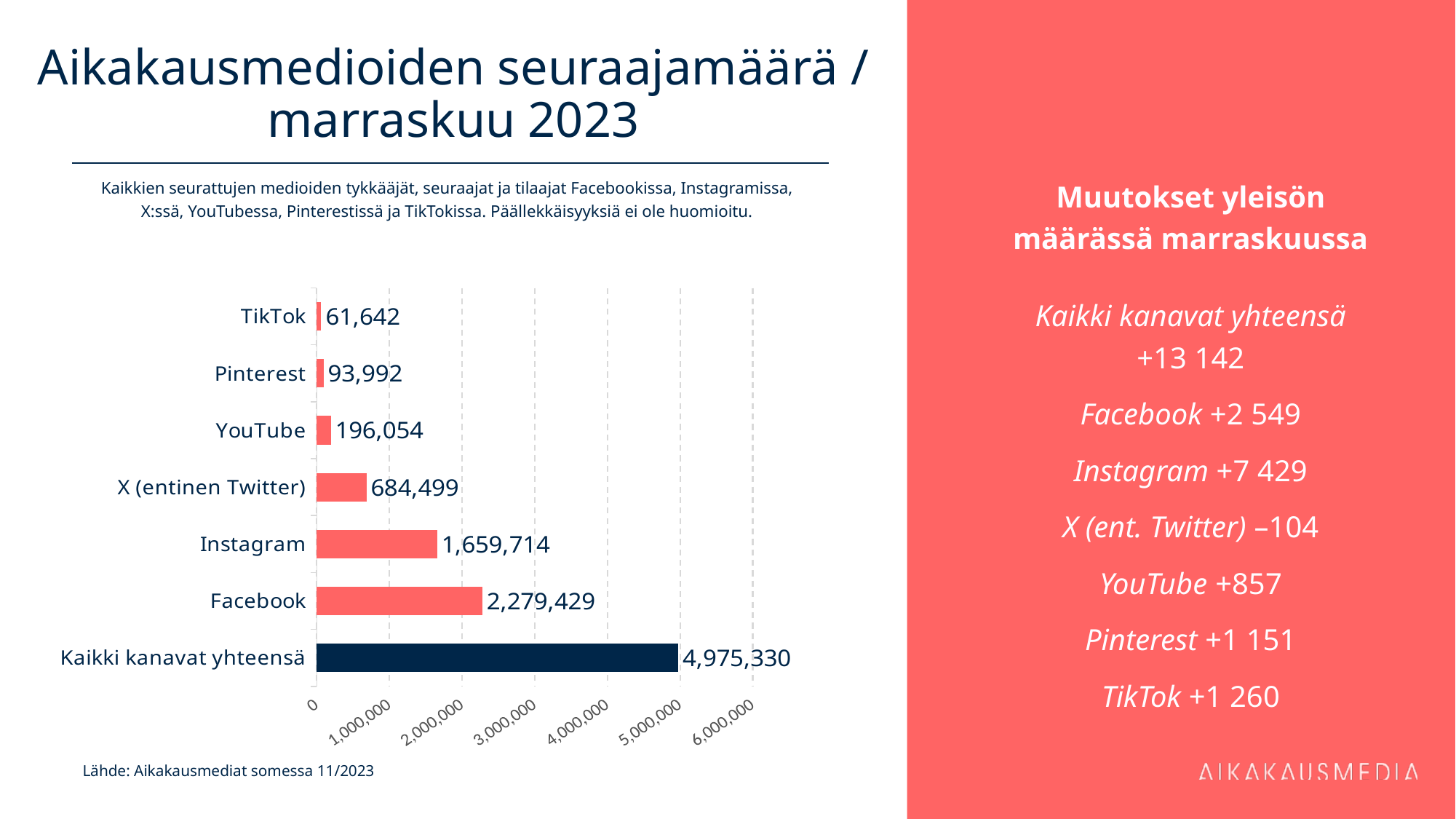
Which is larger, the value for Pinterest or the value for TikTok? Pinterest What is the value for Instagram? 1,659,714 What is the value for Kaikki kanavat yhteensä? 4,975,330 What is the value for X (entinen Twitter)? 684,499 Which category has the lowest value? TikTok Which category has the highest value? Kaikki kanavat yhteensä How many categories are shown in the chart? 7 What is the difference between the values for Facebook and Instagram? 619,715 What is the value for Facebook? 2,279,429 Is the value for X (entinen Twitter) greater or less than 1,000,000? less What is the difference between the values for YouTube and Pinterest? 102,062 What kind of chart is shown on the slide? bar chart